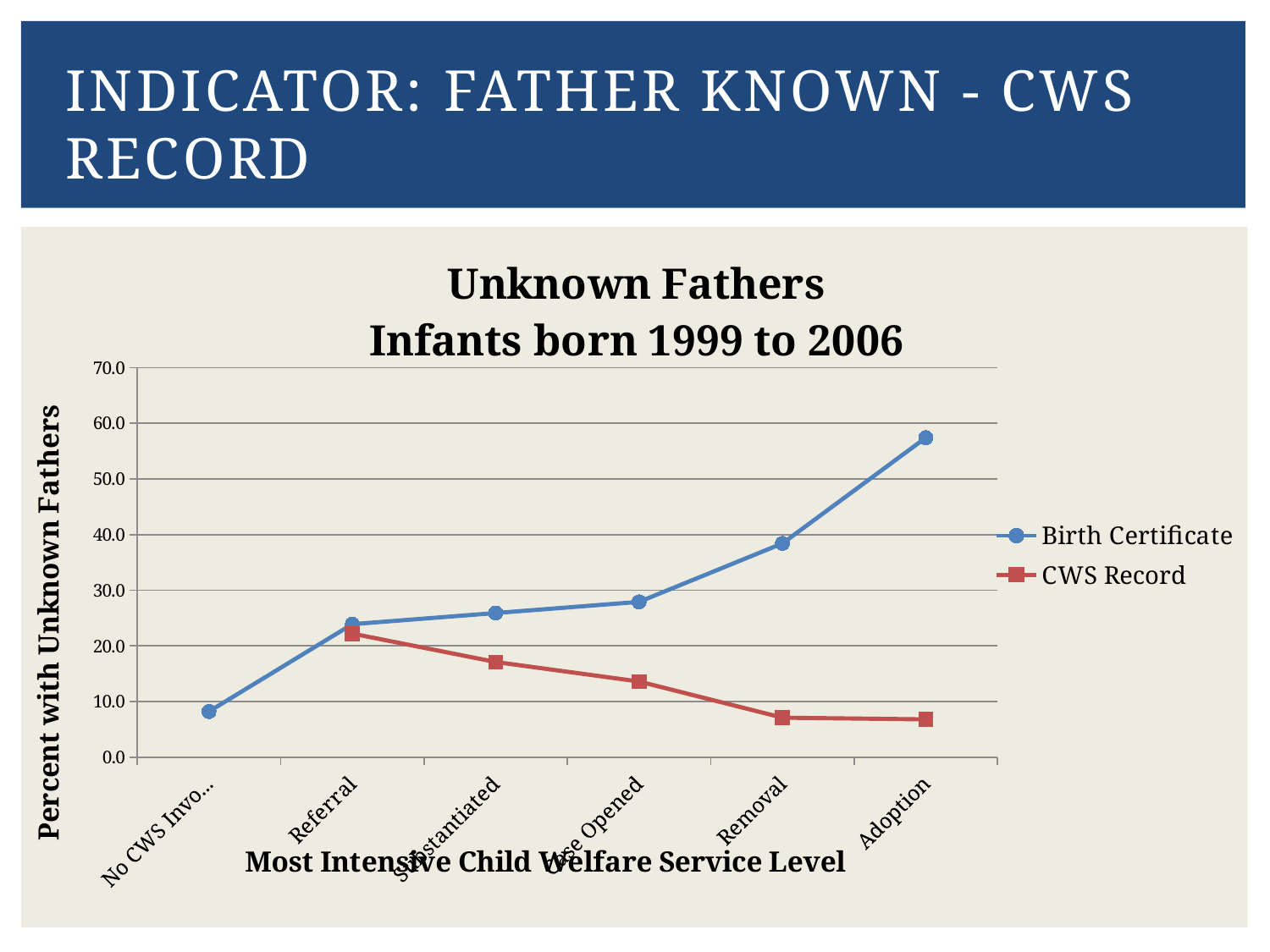
How many series does the legend list? 2 At Removal, which series has the larger value, Birth Certificate or CWS Record? Birth Certificate For which service level is the Birth Certificate series lowest? No CWS Involvement Is the CWS Record value for Removal greater or less than 10.0? less What kind of chart is shown on the slide? Line chart Is the Birth Certificate value for Adoption greater or less than 50.0? greater Is the Birth Certificate value for Removal greater or less than 30.0? greater What is the label on the y axis of the chart? Percent with Unknown Fathers How many service-level categories are plotted along the x axis? 6 For which service level is the CWS Record series highest? Referral Does the CWS Record series rise or fall as the service level moves from Referral to Adoption? Fall For which service level is the Birth Certificate series highest? Adoption